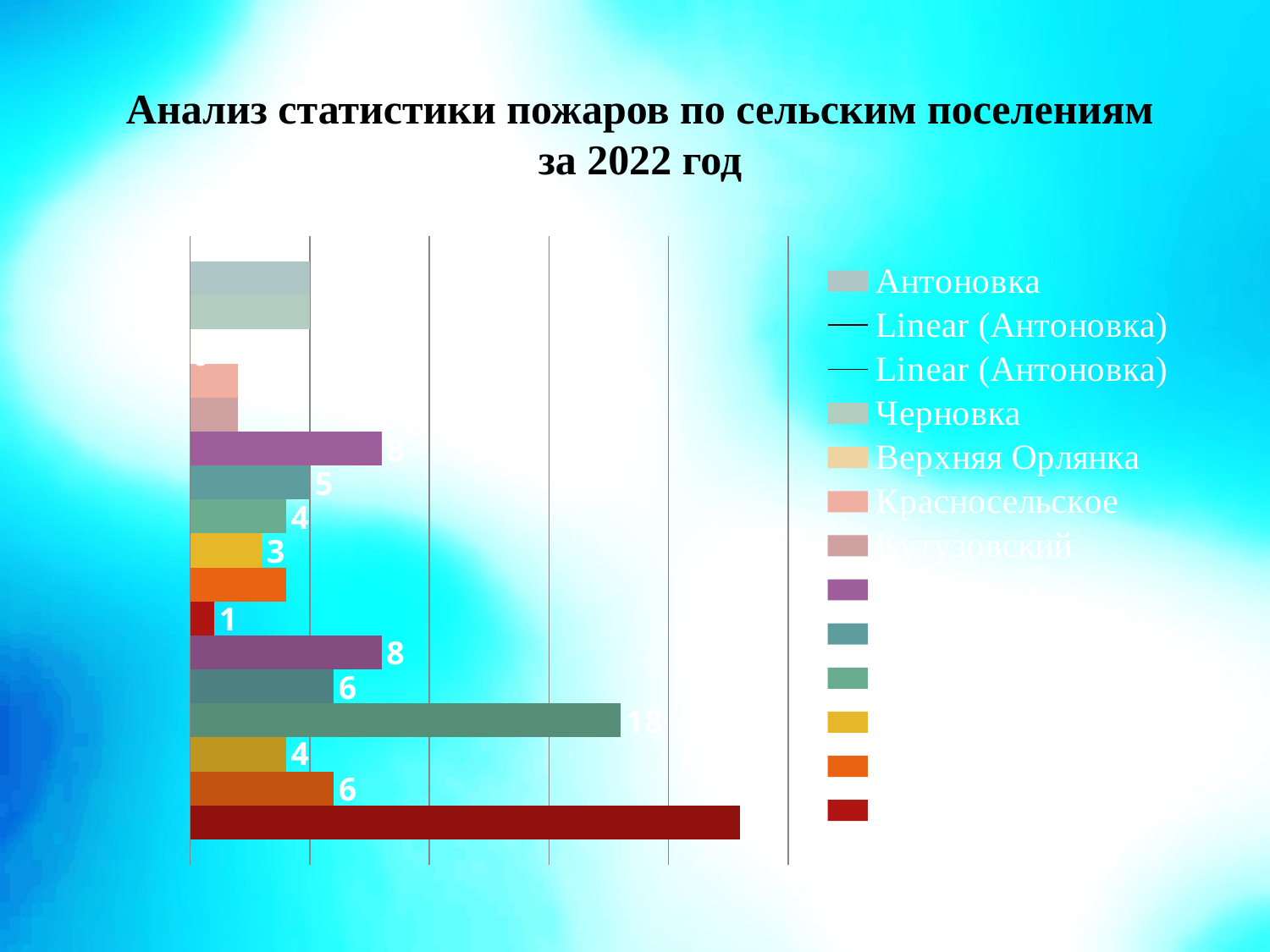
What kind of chart is shown on the slide? Bar chart What is the difference between the largest printed data label (18) and the smallest printed data label (1)? 17 Which bar is the longest in the chart? The dark red bar at the bottom How many legend entries are named "Linear (Антоновка)"? 2 What is the smallest data label printed on any bar in the chart? 1 Which year does the chart title say the fire statistics are for? 2022 How many bars in the chart carry the data label 8? 2 How many bars in the chart carry the data label 6? 2 Is the bar labelled 18 longer or shorter than the bar labelled 8 directly above it? Longer What is the largest data label printed on any bar in the chart? 18 What is the title of the chart on the slide? Анализ статистики пожаров по сельским поселениям за 2022 год